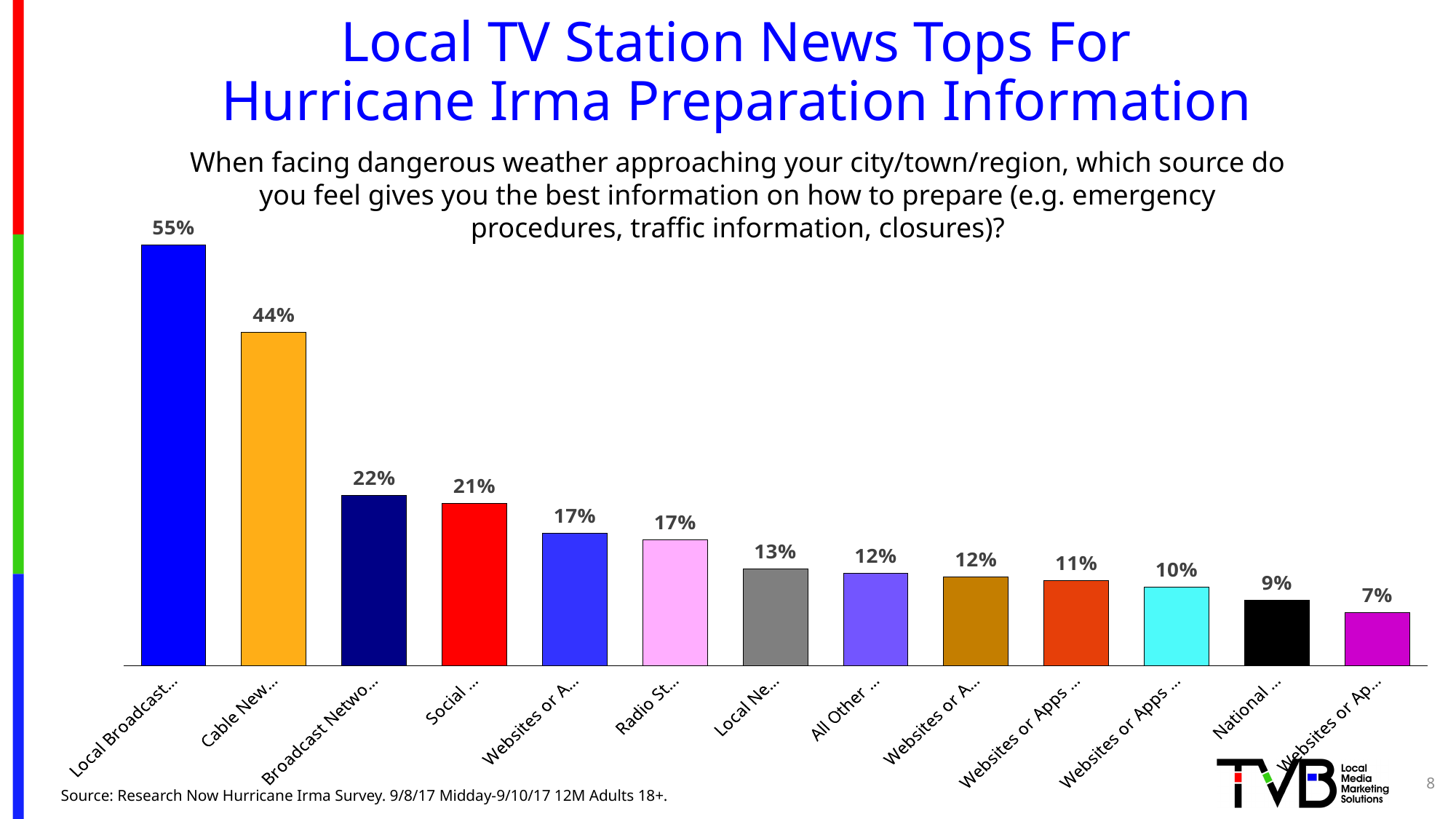
What value is shown for the last bar on the right, labeled "Websites or Ap..."? 7% What kind of chart is shown on the slide? Bar chart What value is shown for the bar labeled "Radio St..."? 17% How many bars are plotted in the chart? 13 Which bar has the highest value? Local Broadcast... (55%) Which is larger, the value for "Broadcast Netwo..." or the value for "Social ..."? Broadcast Netwo... (22%) What value is shown for the bar labeled "National ..."? 9% Which bar has the lowest value? Websites or Ap... (the last bar, 7%) What value is shown for the bar labeled "Cable New..."? 44% What is the difference between the first bar (55%) and the second bar (44%)? 11 percentage points Do the bar values rise or fall from left to right across the chart? Fall What value is shown for the first bar, labeled "Local Broadcast..."? 55%